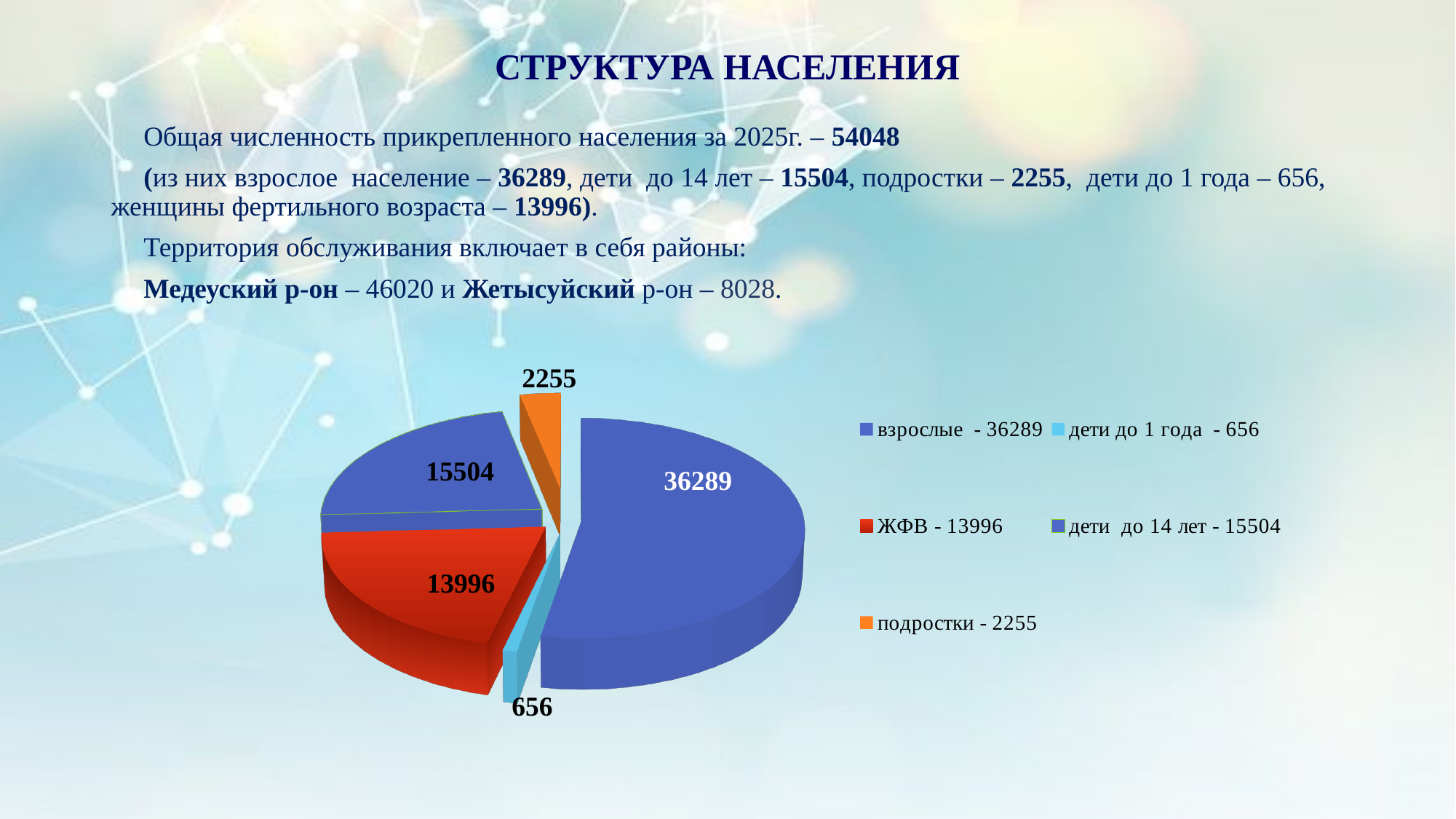
What is the difference between the values for дети до 14 лет and ЖФВ? 1508 What is the value for взрослые in the pie chart? 36289 What kind of chart is shown on the slide? pie chart Which category has the largest slice in the pie chart? взрослые What is the value for подростки in the pie chart? 2255 What is the value for дети до 1 года in the pie chart? 656 What is the difference between the values for взрослые and дети до 14 лет? 20785 What is the value for ЖФВ in the pie chart? 13996 Which is larger, the value for дети до 14 лет or the value for ЖФВ? дети до 14 лет How many slices does the pie chart have? 5 What colour is the ЖФВ slice in the pie chart? red Which category has the smallest slice in the pie chart? дети до 1 года